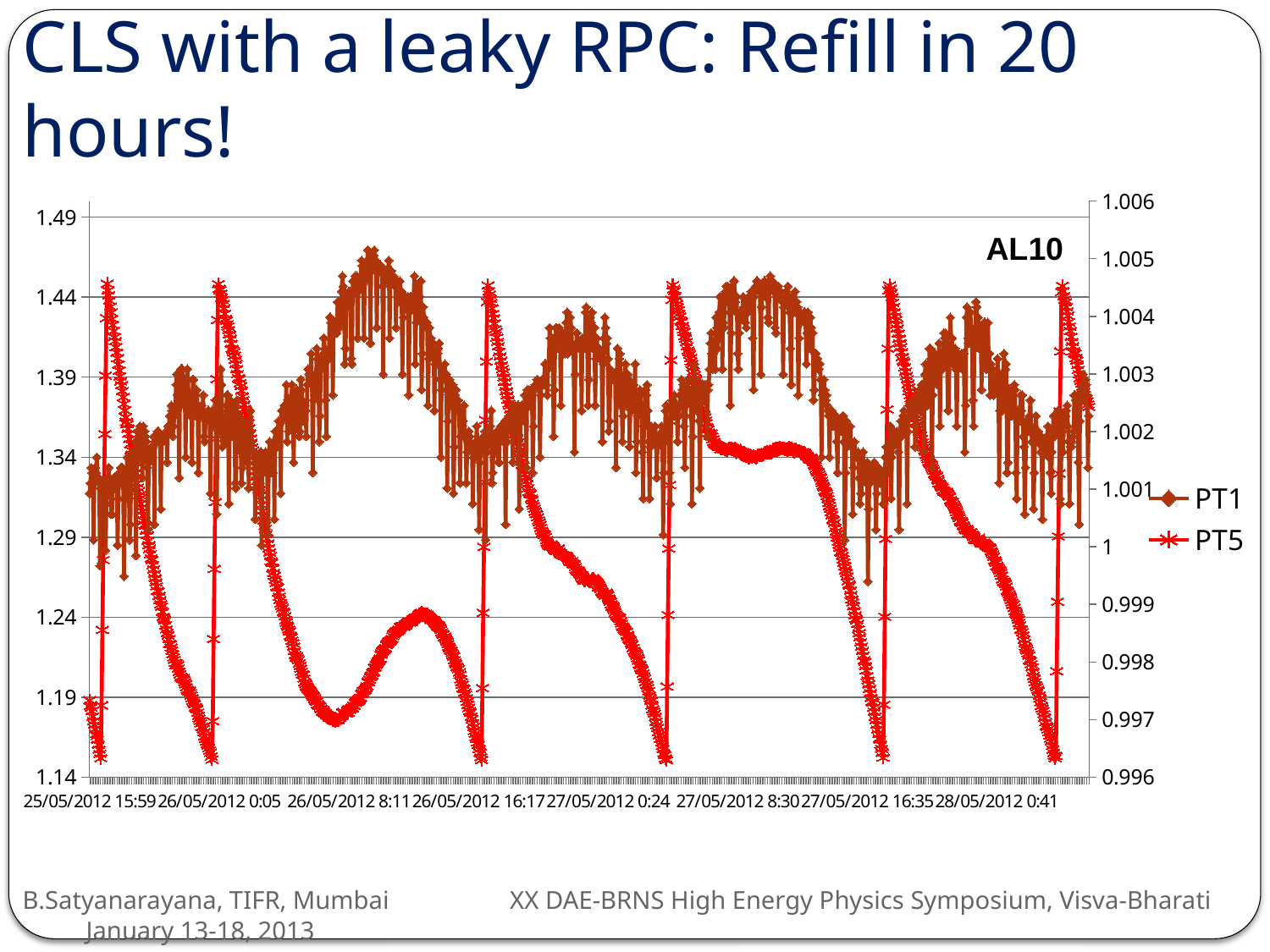
What is the first date-time label on the horizontal axis? 25/05/2012 15:59 Does the PT5 series show a pattern of sudden rises followed by gradual falls, or gradual rises followed by sudden falls? sudden rises followed by gradual falls What is the last date-time label on the horizontal axis? 28/05/2012 0:41 What label is printed inside the plot area near the top right? AL10 What is the lowest value shown on the right vertical axis? 0.996 What is the highest value shown on the left vertical axis? 1.49 How many date-time labels are printed along the horizontal axis? 8 What is the highest value shown on the right vertical axis? 1.006 What is the lowest value shown on the left vertical axis? 1.14 How many series does the legend list? 2 What are the names of the two series in the legend? PT1 and PT5 What kind of chart is shown on the slide? line chart